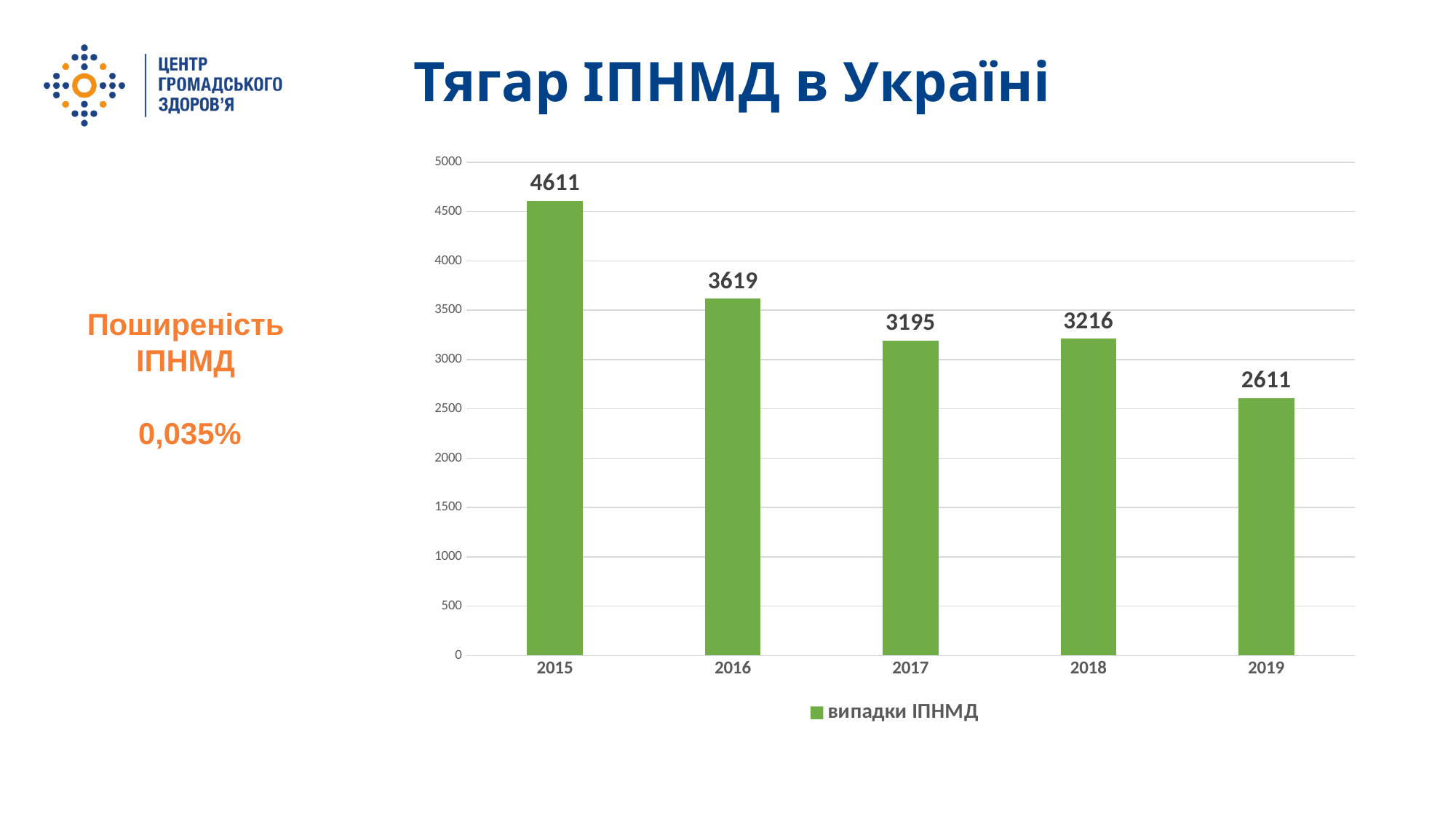
What is the value for 2015? 4611 Which year has the lowest value? 2019 What kind of chart is shown on the slide? bar chart Is the value for 2019 greater or less than 3000? less What is the value for 2019? 2611 What is the difference between the values for 2018 and 2019? 605 What is the difference between the values for 2015 and 2016? 992 Which year has the highest value? 2015 Which is larger, the value for 2016 or the value for 2018? 2016 What is the legend entry for the series? випадки ІПНМД What is the value for 2017? 3195 How many years are shown on the x axis? 5